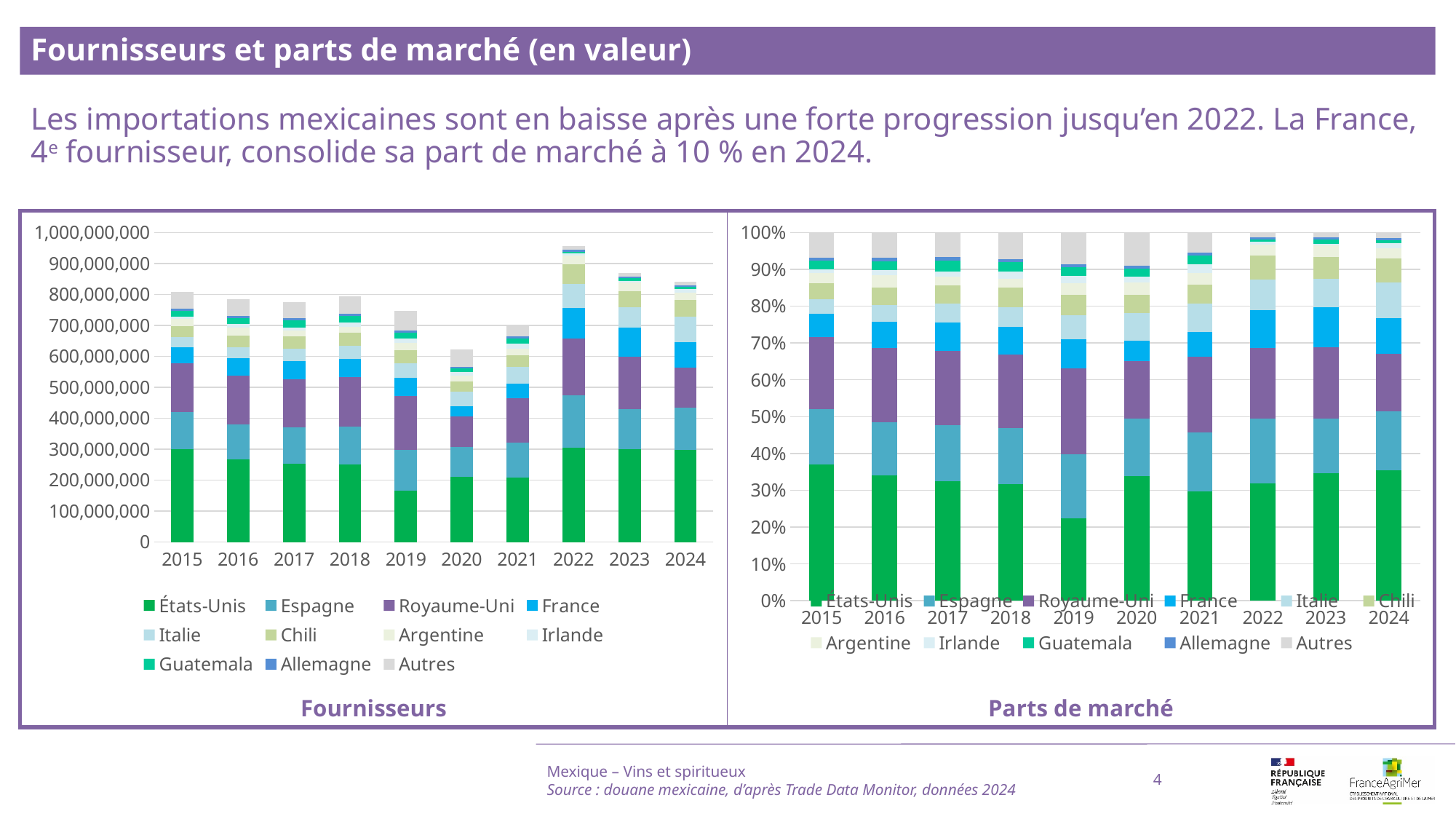
What kind of chart is the 'Fournisseurs' chart on the left? Stacked bar chart How many years are shown on the x axis of the 'Fournisseurs' chart? 10 In the 'Fournisseurs' chart, is the total bar for 2022 greater or less than 900,000,000? greater In the 'Fournisseurs' chart, which year has the lowest total bar? 2020 In the 'Fournisseurs' chart, do the total bars rise or fall from 2022 to 2024? fall How many series does the legend of the 'Parts de marché' chart list? 11 In the 'Parts de marché' chart, is the États-Unis share in 2019 greater or less than 30%? less In the 'Fournisseurs' chart, which year has the highest total bar? 2022 In the 'Fournisseurs' chart, is the total bar for 2020 greater or less than 700,000,000? less In the 'Fournisseurs' chart, which total bar is larger, 2019 or 2020? 2019 What is the title shown under the right-hand chart? Parts de marché